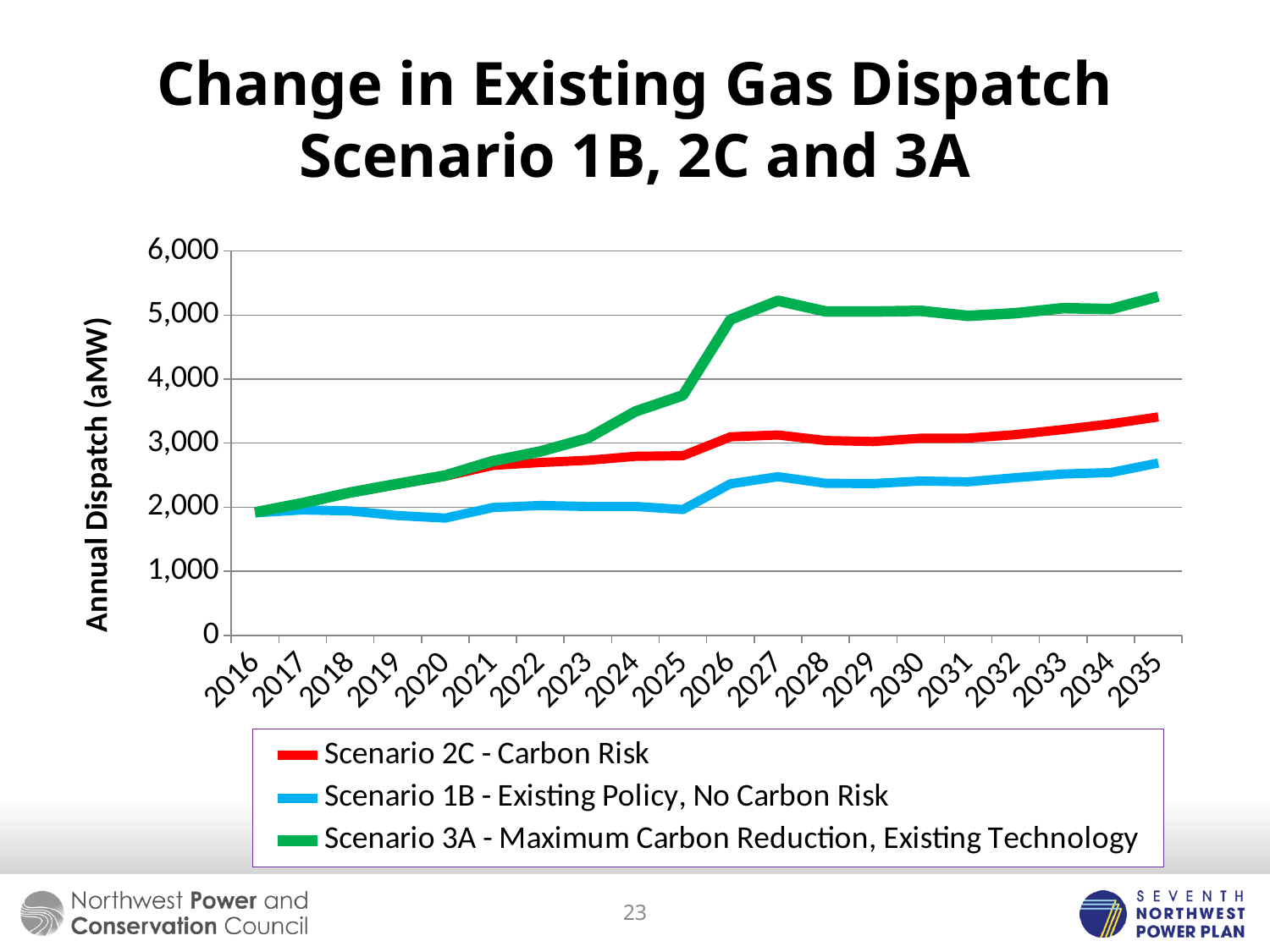
Is the value for Scenario 1B in 2035 greater or less than 3,000? less Which scenario has the lowest annual dispatch in 2030? Scenario 1B - Existing Policy, No Carbon Risk How many series does the legend list? 3 Which scenario has the highest annual dispatch in 2035? Scenario 3A - Maximum Carbon Reduction, Existing Technology In 2030, which is larger: the value for Scenario 2C or the value for Scenario 1B? Scenario 2C Does the Scenario 3A line generally rise or fall from 2016 to 2035? rise Is the value for Scenario 2C in 2035 greater or less than 3,000? greater How many years are shown along the x axis? 20 What kind of chart is shown on the slide? line chart Is the value for Scenario 3A in 2025 greater or less than 4,000? less What is the title of the y axis? Annual Dispatch (aMW)